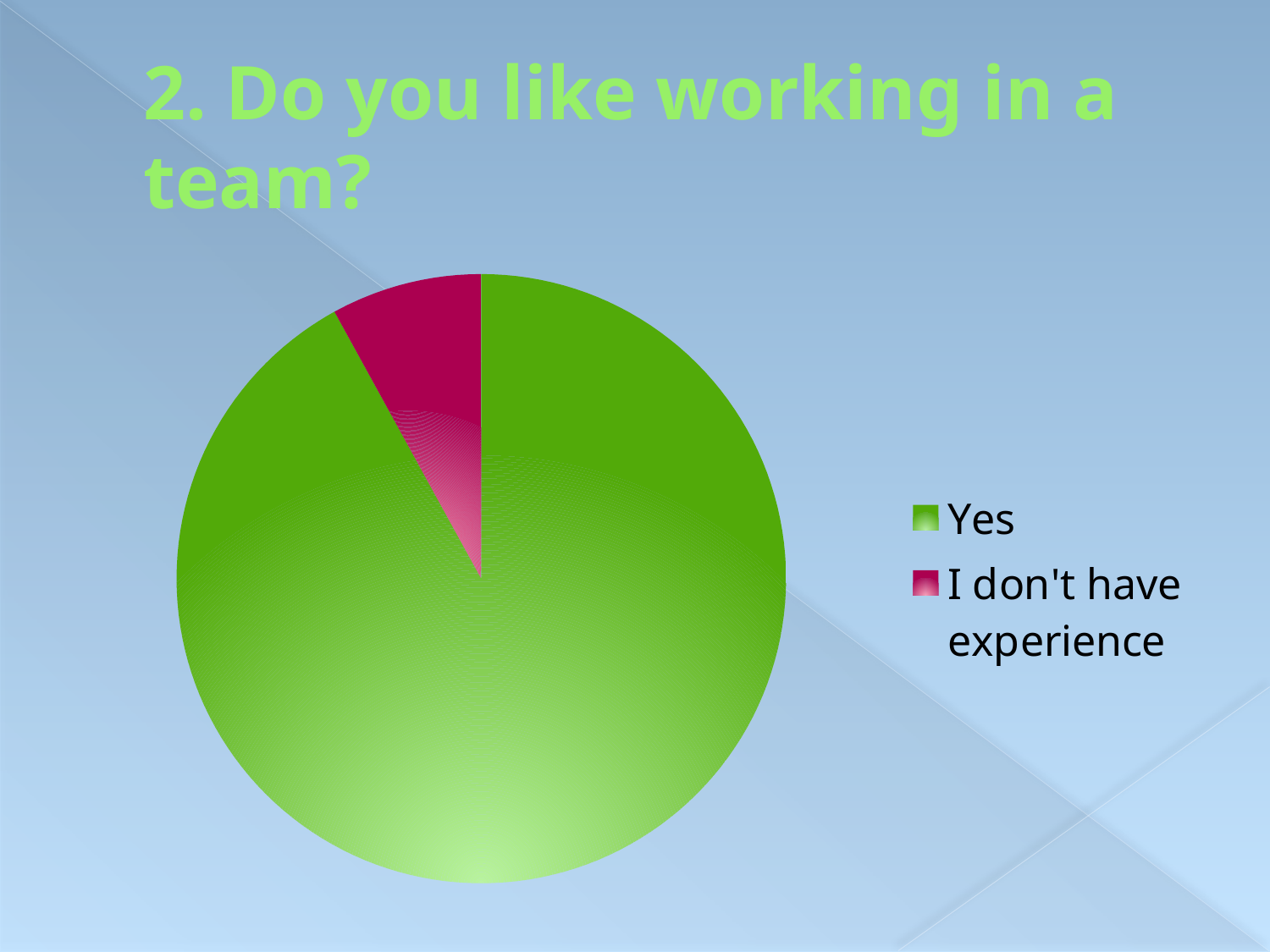
How many slices does the pie chart have? 2 Which slice of the pie chart is the largest? Yes How many entries does the legend list? 2 What kind of chart is shown on the slide? pie chart What colour is the "Yes" slice in the pie chart? green Which slice of the pie chart is the smallest? I don't have experience What colour is the "I don't have experience" slice in the pie chart? magenta Which slice is larger, "Yes" or "I don't have experience"? Yes